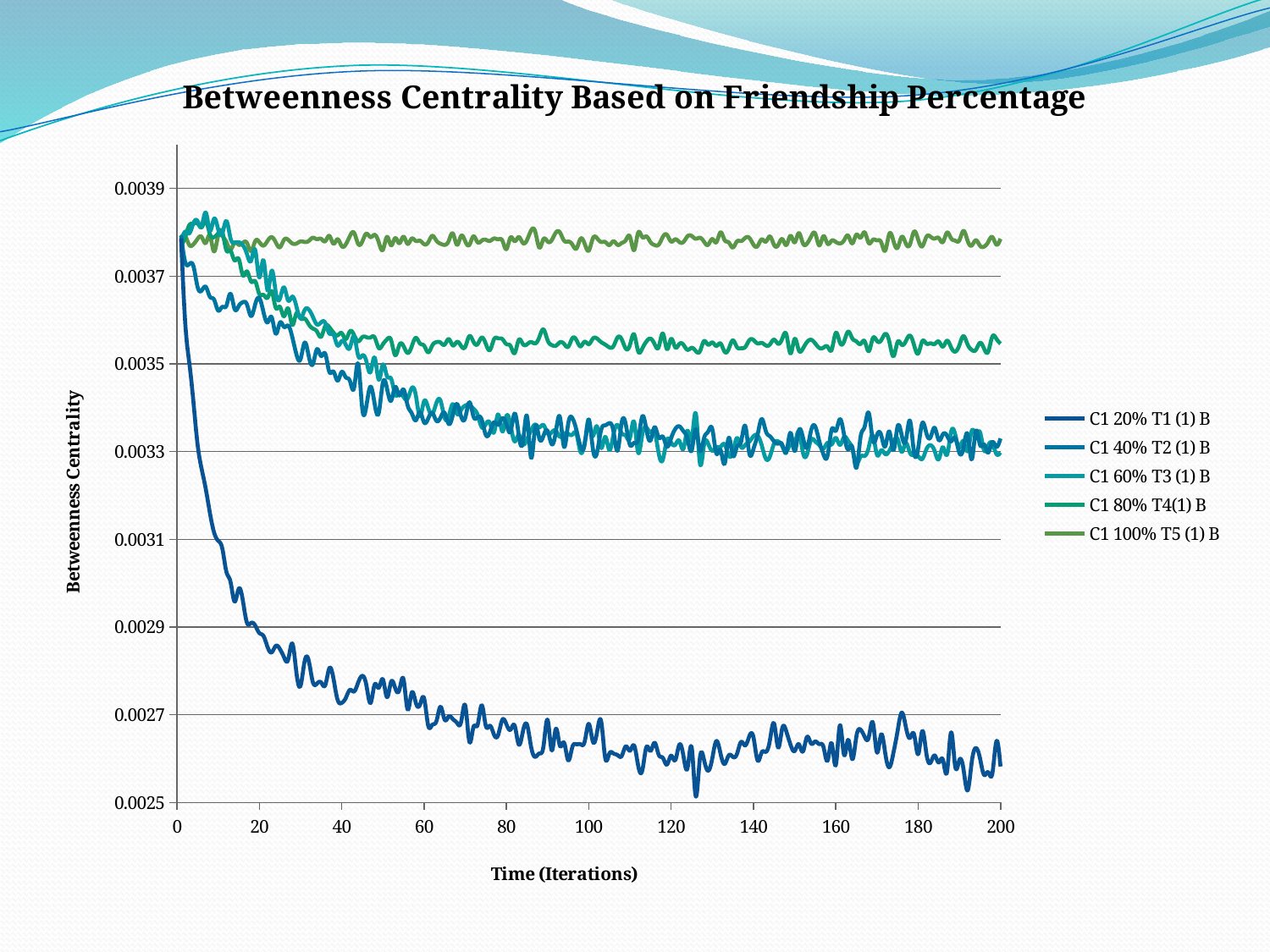
What is the title of the chart? Betweenness Centrality Based on Friendship Percentage How many series does the legend list? 5 Is the value for C1 80% T4(1) B at iteration 150 greater or less than 0.0035? greater Is the value for C1 100% T5 (1) B at iteration 100 greater or less than 0.0037? greater Is the value for C1 20% T1 (1) B at iteration 200 greater or less than 0.0027? less What kind of chart is shown on the slide? Line chart Which series has the lowest values at iteration 200? C1 20% T1 (1) B Do the values for C1 20% T1 (1) B rise or fall as the iterations increase from 0 to 200? fall Do the values for C1 40% T2 (1) B rise or fall as the iterations increase from 0 to 100? fall What is the label of the x axis? Time (Iterations) At iteration 180, which series has the larger value: C1 100% T5 (1) B or C1 60% T3 (1) B? C1 100% T5 (1) B Which series has the highest values at iteration 200? C1 100% T5 (1) B